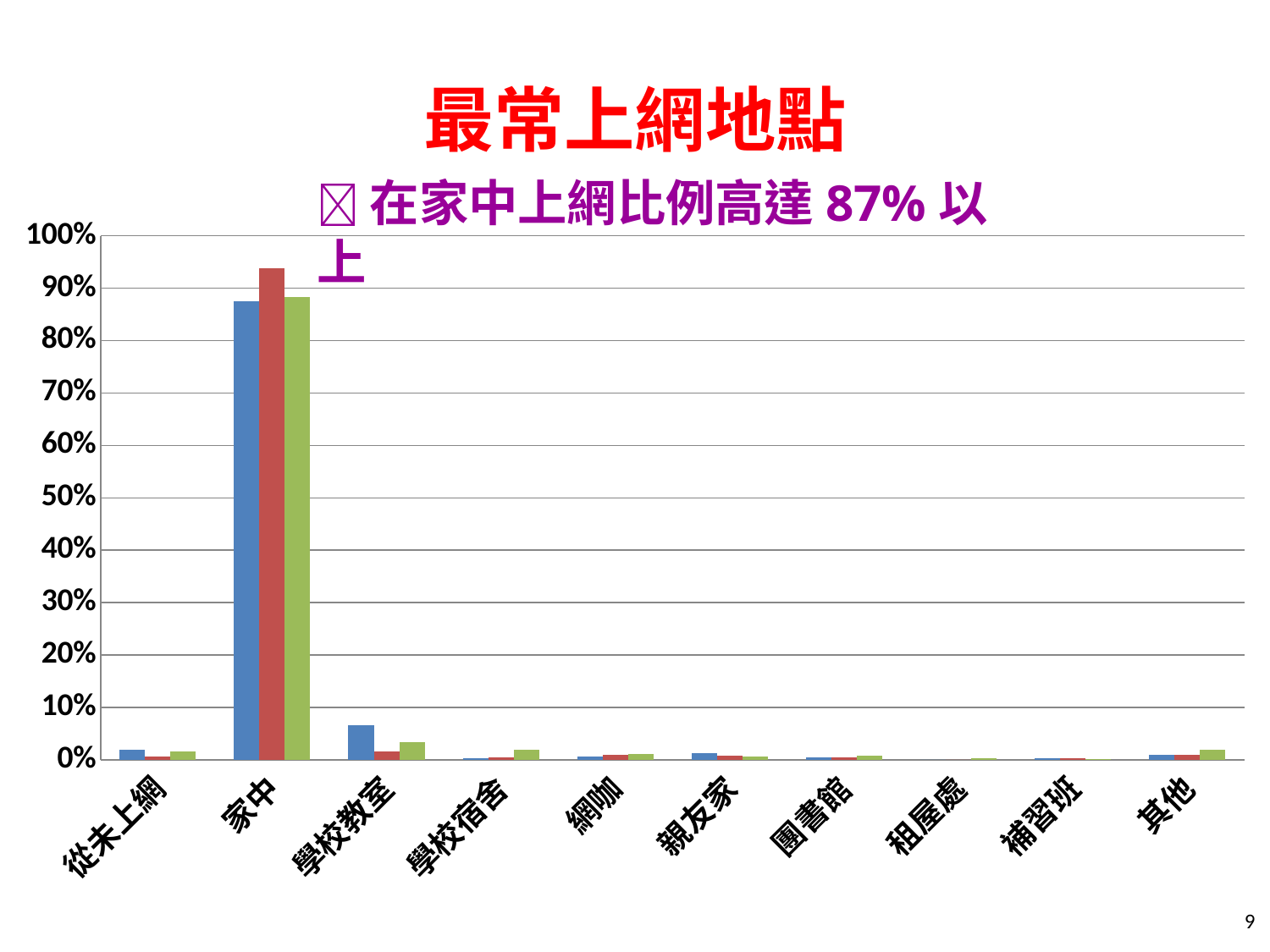
Is the value of the blue bar for 學校教室 greater or less than 10%? less For 家中, which bar is taller: the blue bar or the red bar? the red bar Is the value of the blue bar for 家中 greater or less than 80%? greater For 學校教室, which bar is taller: the blue bar or the red bar? the blue bar Is the value of the red bar for 家中 greater or less than 90%? greater Which category has the highest values in the chart? 家中 How many categories are shown along the x axis of the chart? 10 What is the title of the chart on the slide? 最常上網地點 Which category has the second-highest blue bar after 家中? 學校教室 What kind of chart is shown on the slide? bar chart How many bars are plotted for each category in the chart? 3